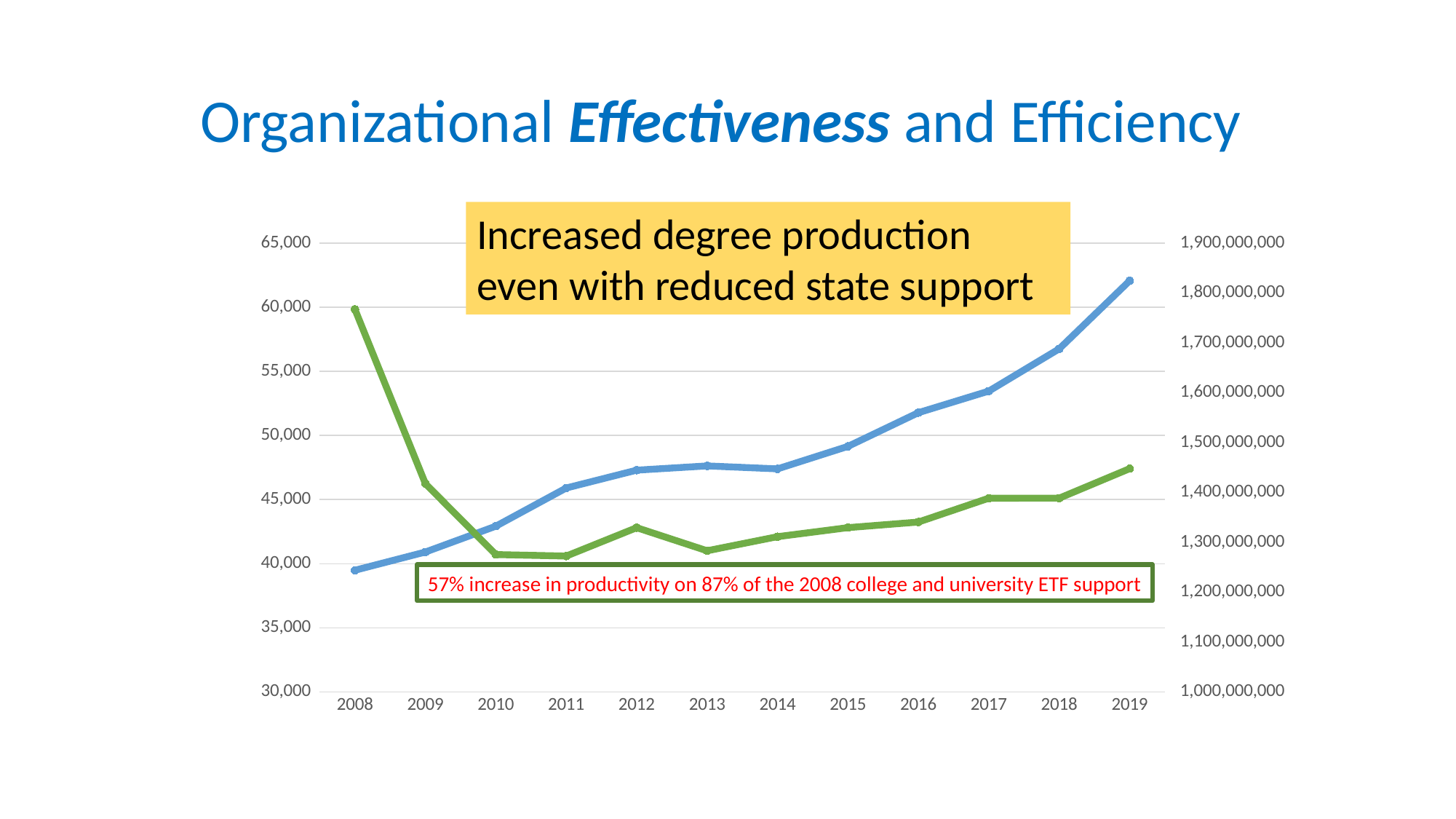
How many lines are plotted on the chart? 2 Does the green line rise or fall between 2008 and 2010? Fall What does the yellow callout box on the chart say? Increased degree production even with reduced state support In which year is the blue line at its lowest point? 2008 Does the blue line generally rise or fall from 2008 to 2019? Rise How many years are plotted along the x axis of the chart? 12 In which year does the blue line reach its highest point? 2019 Read against the left axis, is the blue line's value in 2008 greater or less than 40,000? less In 2008, which line is higher on the chart, the blue line or the green line? Green line What type of chart is shown on the slide? Line chart In 2019, which line is higher on the chart, the blue line or the green line? Blue line In which year does the green line reach its highest point? 2008